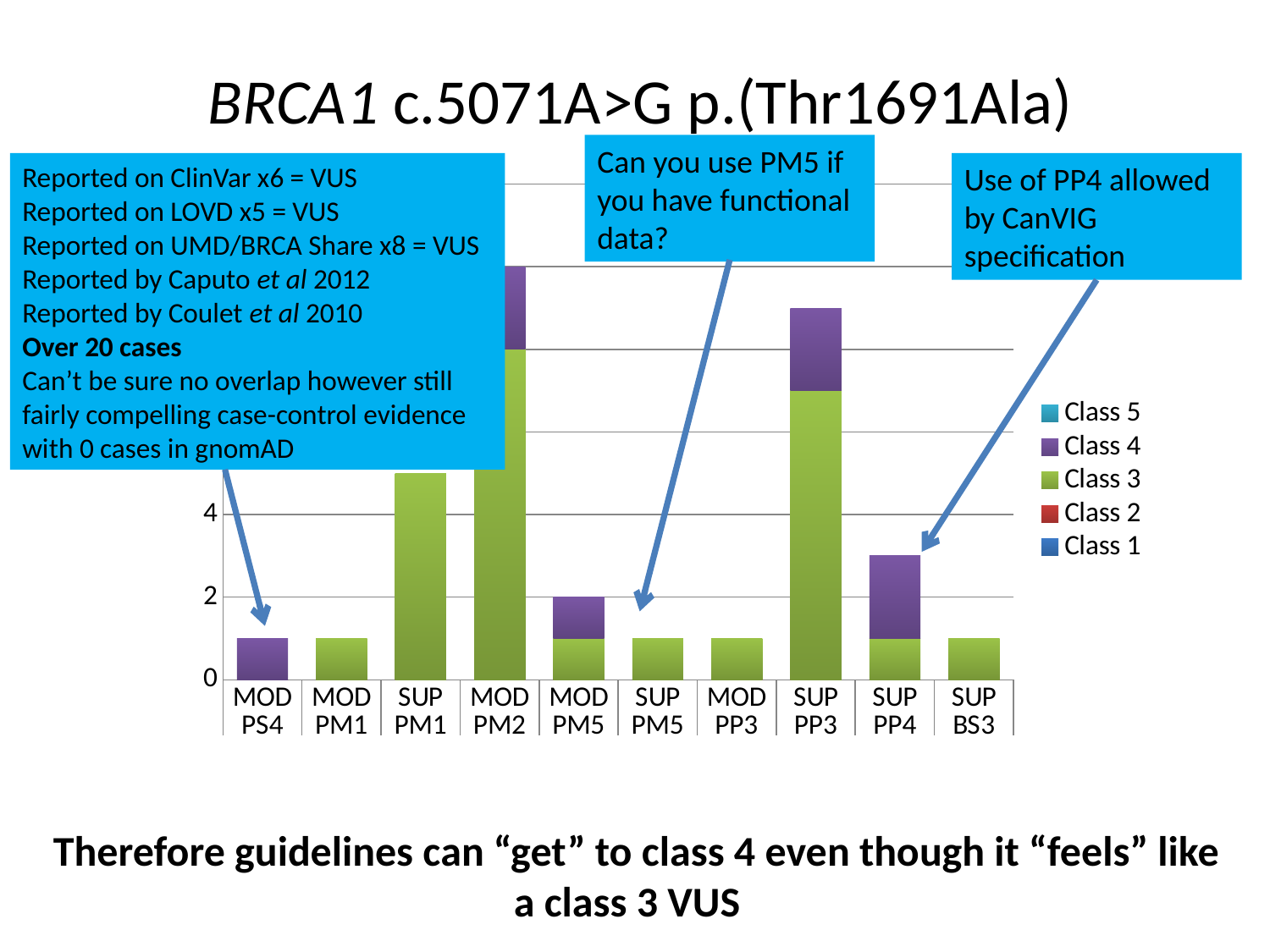
Is the total value for SUP PP4 greater or less than 2? greater Which category has the tallest stacked bar? MOD PM2 Is the value for MOD PS4 greater or less than 2? less Is the total value for SUP PM1 greater or less than 4? greater What kind of chart is shown on the slide? stacked bar chart How many series does the chart legend list? 5 What is the total height of the stacked bar for MOD PM5? 2 How many categories are shown along the x axis of the chart? 10 Which legend entry is shown in green? Class 3 Which stacked bar is taller, SUP PM1 or SUP PP3? SUP PP3 Which legend entry is shown in purple? Class 4